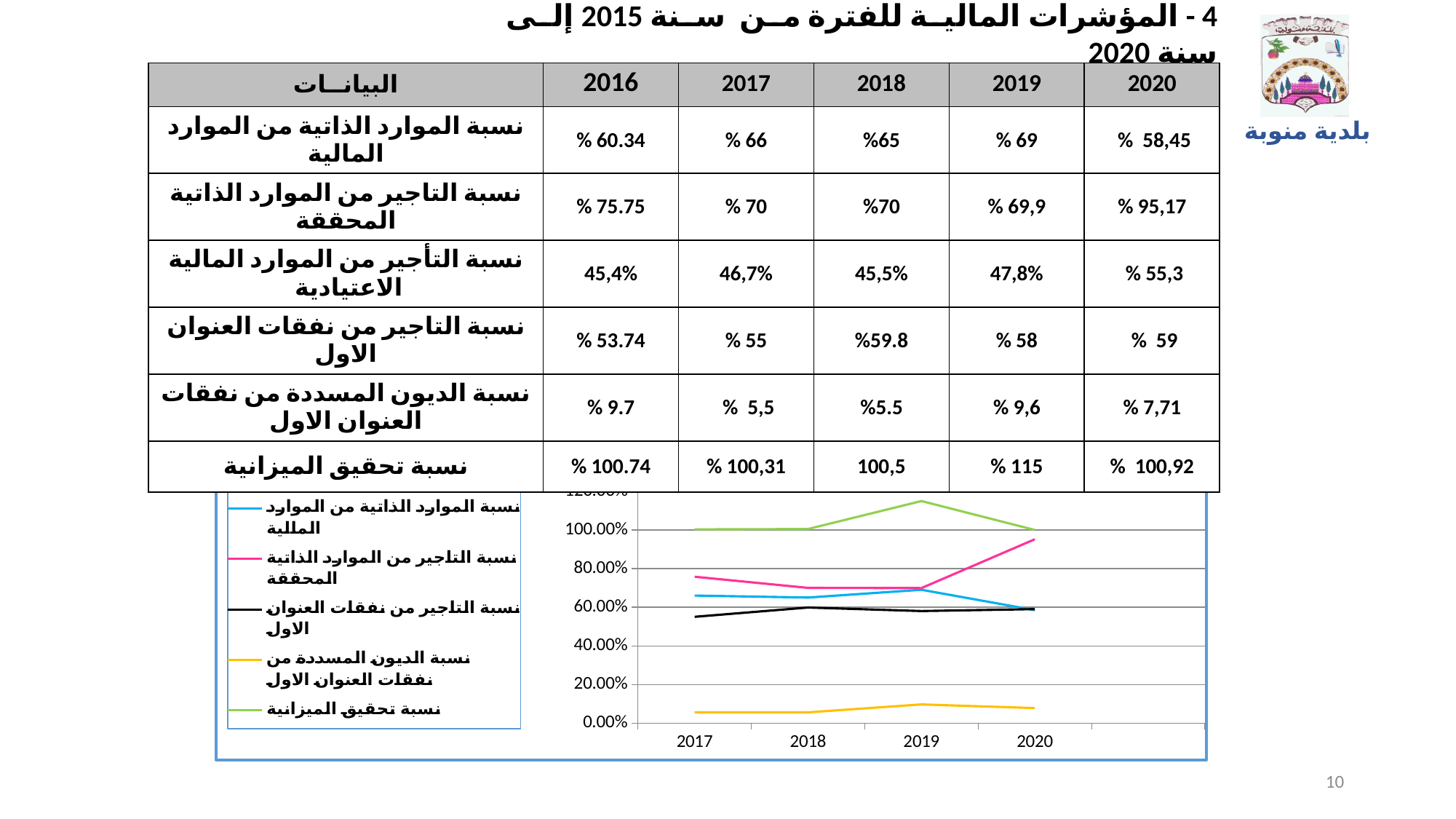
Which series has the highest value in 2019 on the chart? نسبة تحقيق الميزانية Is the value for نسبة التاجير من الموارد الذاتية المحققة in 2020 greater or less than 80.00%? greater Does the line for نسبة تحقيق الميزانية rise or fall from 2019 to 2020? fall Is the value for نسبة الديون المسددة من نفقات العنوان الاول in 2020 greater or less than 20.00%? less In 2020, which is larger on the chart: نسبة التاجير من الموارد الذاتية المحققة or نسبة الموارد الذاتية من الموارد المالية? نسبة التاجير من الموارد الذاتية المحققة How many years are shown on the chart's x axis? 4 Which series has the lowest value in 2020 on the chart? نسبة الديون المسددة من نفقات العنوان الاول What kind of chart is shown at the bottom of the slide? line chart What colour is the line for نسبة تحقيق الميزانية in the chart? green Does the line for نسبة التاجير من الموارد الذاتية المحققة rise or fall from 2019 to 2020? rise How many series does the chart's legend list? 5 Is the value for نسبة تحقيق الميزانية in 2019 greater or less than 100.00%? greater